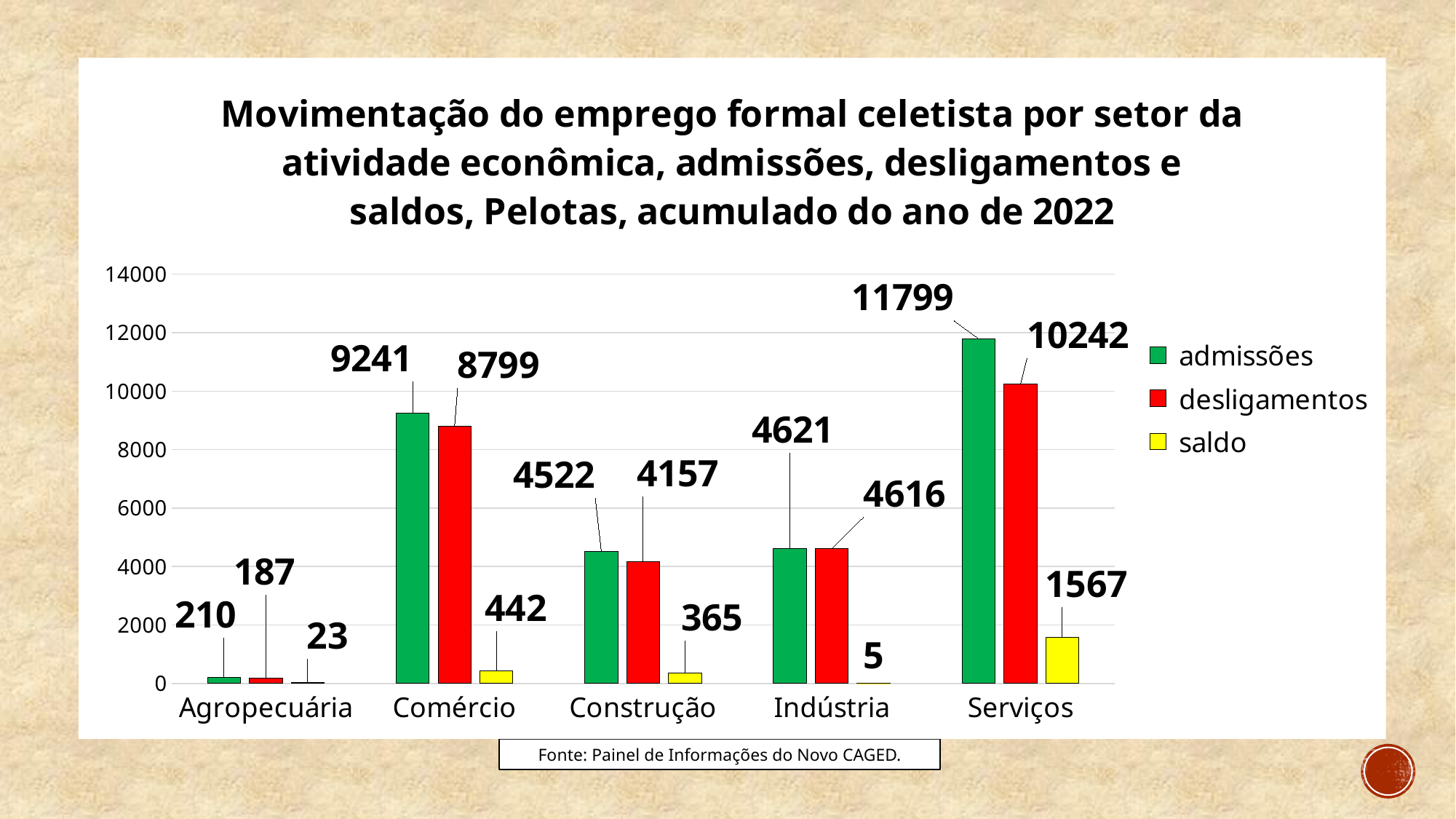
What is the value of desligamentos for Comércio? 8799 How many sectors are shown on the x axis? 5 Is the value of desligamentos for Serviços greater or less than 10000? greater What kind of chart is shown on the slide? bar chart Which is larger for Comércio: admissões or desligamentos? admissões What is the saldo for Indústria? 5 Which sector has the lowest saldo? Indústria What is the value of admissões for Serviços? 11799 What is the difference between admissões and desligamentos for Construção? 365 How many series does the legend list? 3 Which sector has the highest value of admissões? Serviços What colour represents the saldo series in the legend? yellow